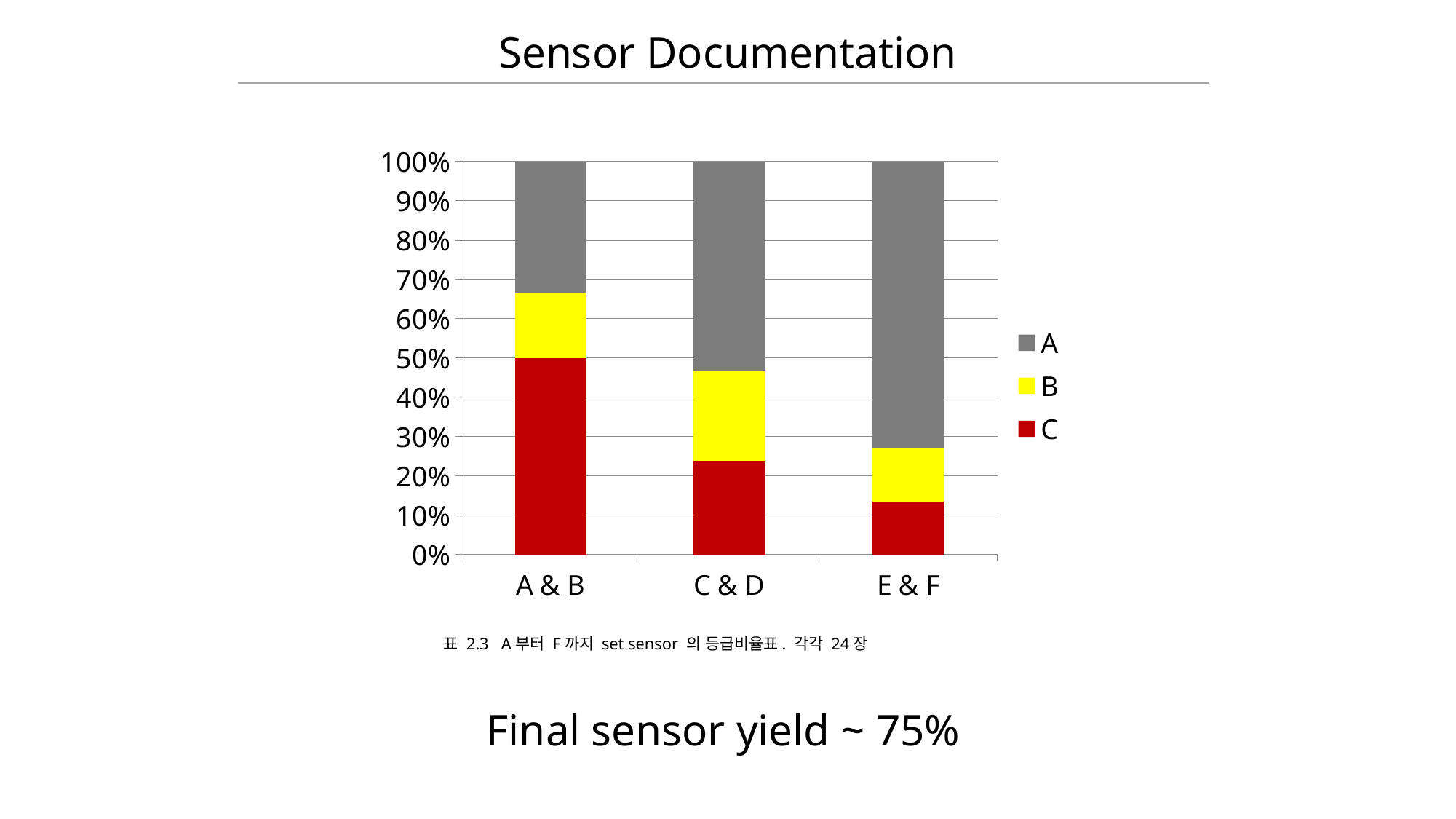
How many series does the chart's legend list? 3 Does the share of C rise or fall from A & B to E & F? fall Which category has the largest C (red) segment? A & B Which category has the smallest C (red) segment? E & F What kind of chart is shown on the slide? stacked bar chart Which category has the largest A (grey) segment? E & F Is the A segment for E & F greater or less than 60%? greater Is the C segment for C & D greater or less than 20%? greater How many categories are shown on the x axis of the chart? 3 Is the A segment for A & B greater or less than 40%? less Which series are listed in the chart's legend? A, B, C What is the total height of each stacked bar in the chart? 100%